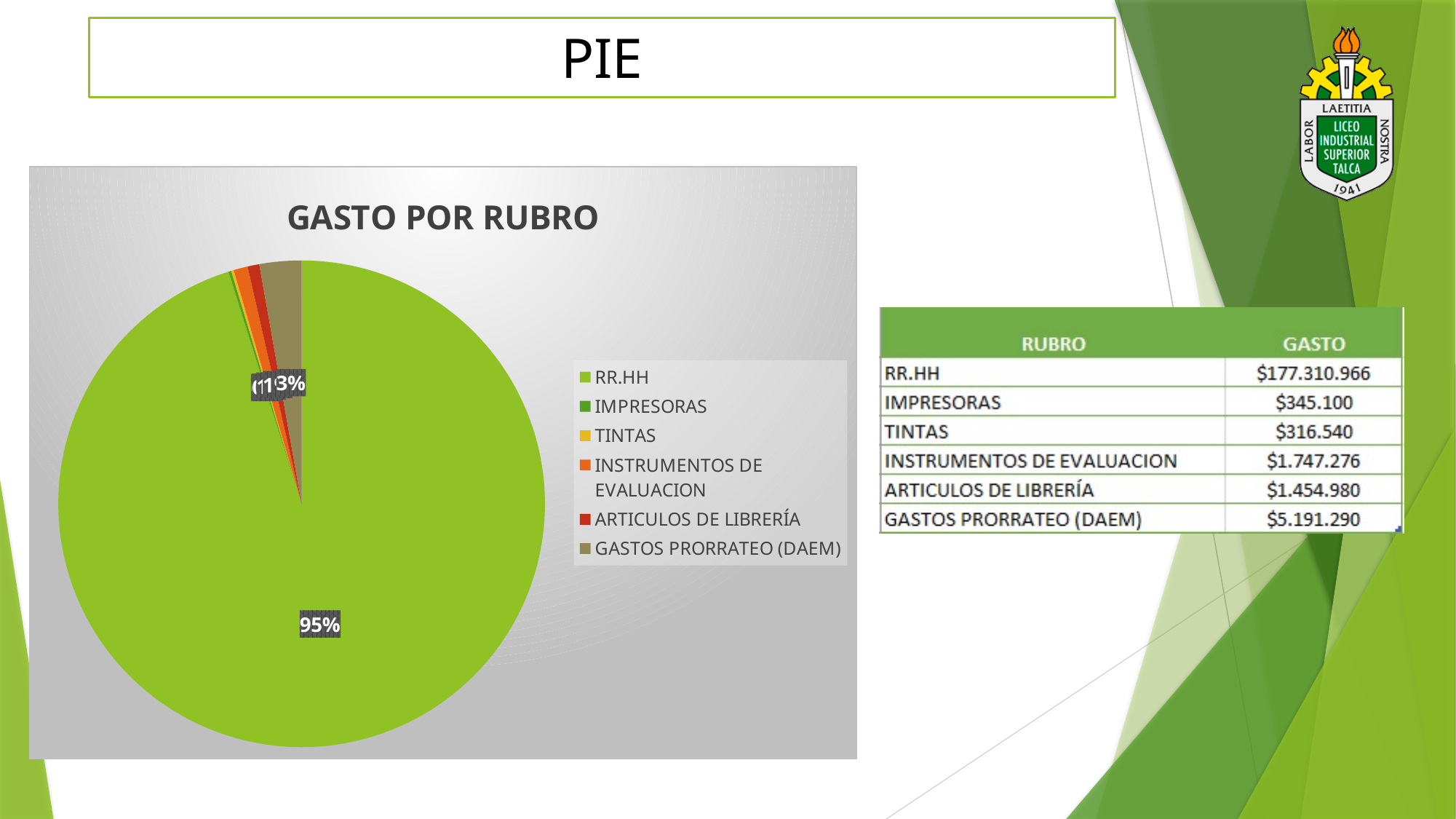
Using the table values, what is the difference between the GASTO for INSTRUMENTOS DE EVALUACION and ARTICULOS DE LIBRERÍA? $292.296 How many categories does the legend of the pie chart list? 6 According to the table, what is the GASTO for TINTAS? $316.540 What share of the pie does GASTOS PRORRATEO (DAEM) represent? 3% According to the table, what is the GASTO for GASTOS PRORRATEO (DAEM)? $5.191.290 What kind of chart is shown on the slide? pie chart Which is larger in the pie chart, RR.HH or INSTRUMENTOS DE EVALUACION? RR.HH What colour is the RR.HH slice in the pie chart? light green Which category has the largest slice in the pie chart? RR.HH What is the title of the pie chart? GASTO POR RUBRO According to the table, what is the GASTO for RR.HH? $177.310.966 What share of the pie does RR.HH represent? 95%